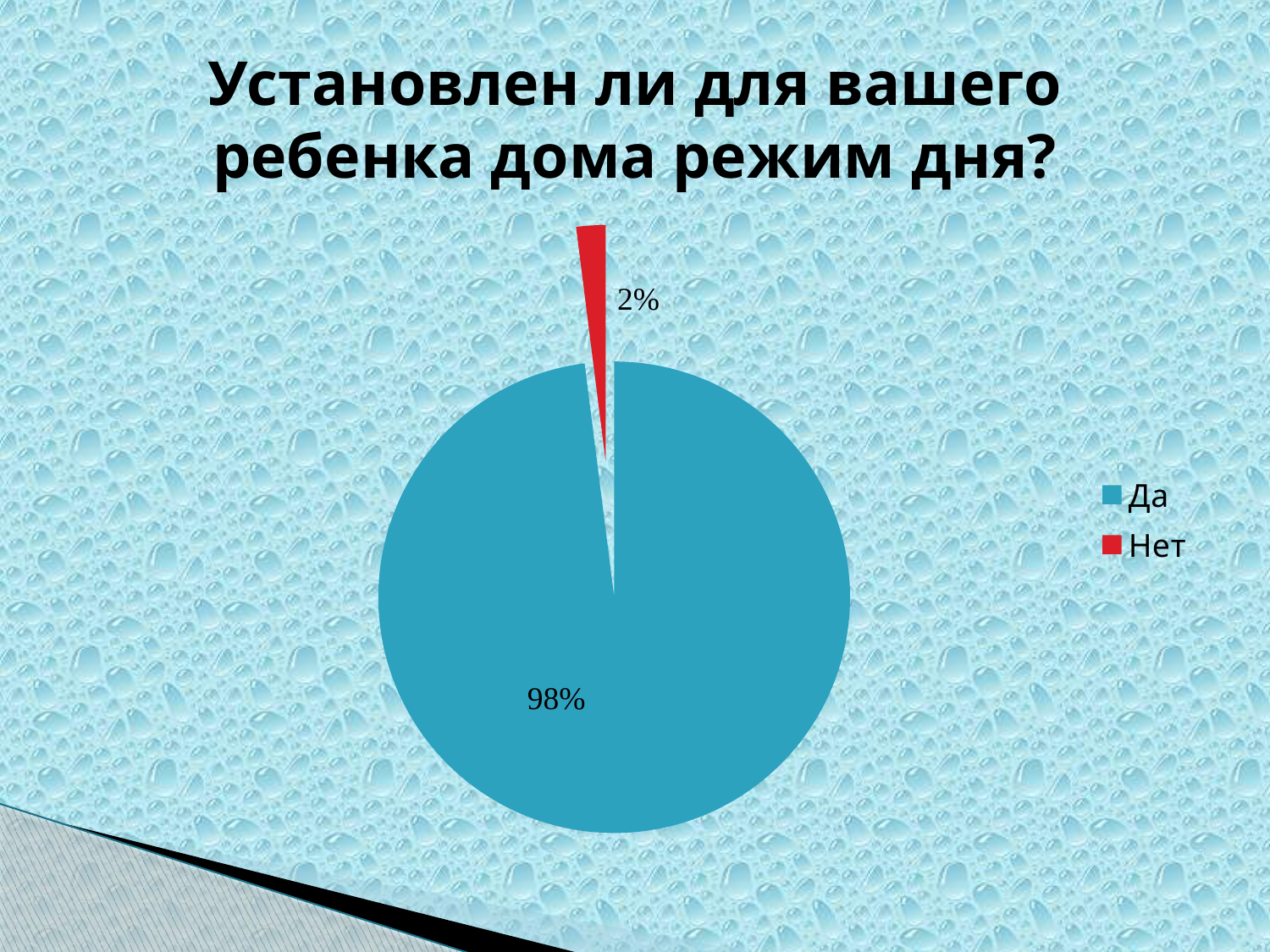
What colour is the slice for "Нет"? red What is the difference in percentage points between the "Да" and "Нет" slices? 96 How many entries does the legend list? 2 What share of the pie does "Нет" have? 2% What is the title of the chart? Установлен ли для вашего ребенка дома режим дня? Which category has the smallest slice of the pie? Нет Which category has the largest slice of the pie? Да How many categories does the pie chart show? 2 Which is larger, the slice for "Да" or the slice for "Нет"? Да What share of the pie does "Да" have? 98% What kind of chart is shown on the slide? pie chart